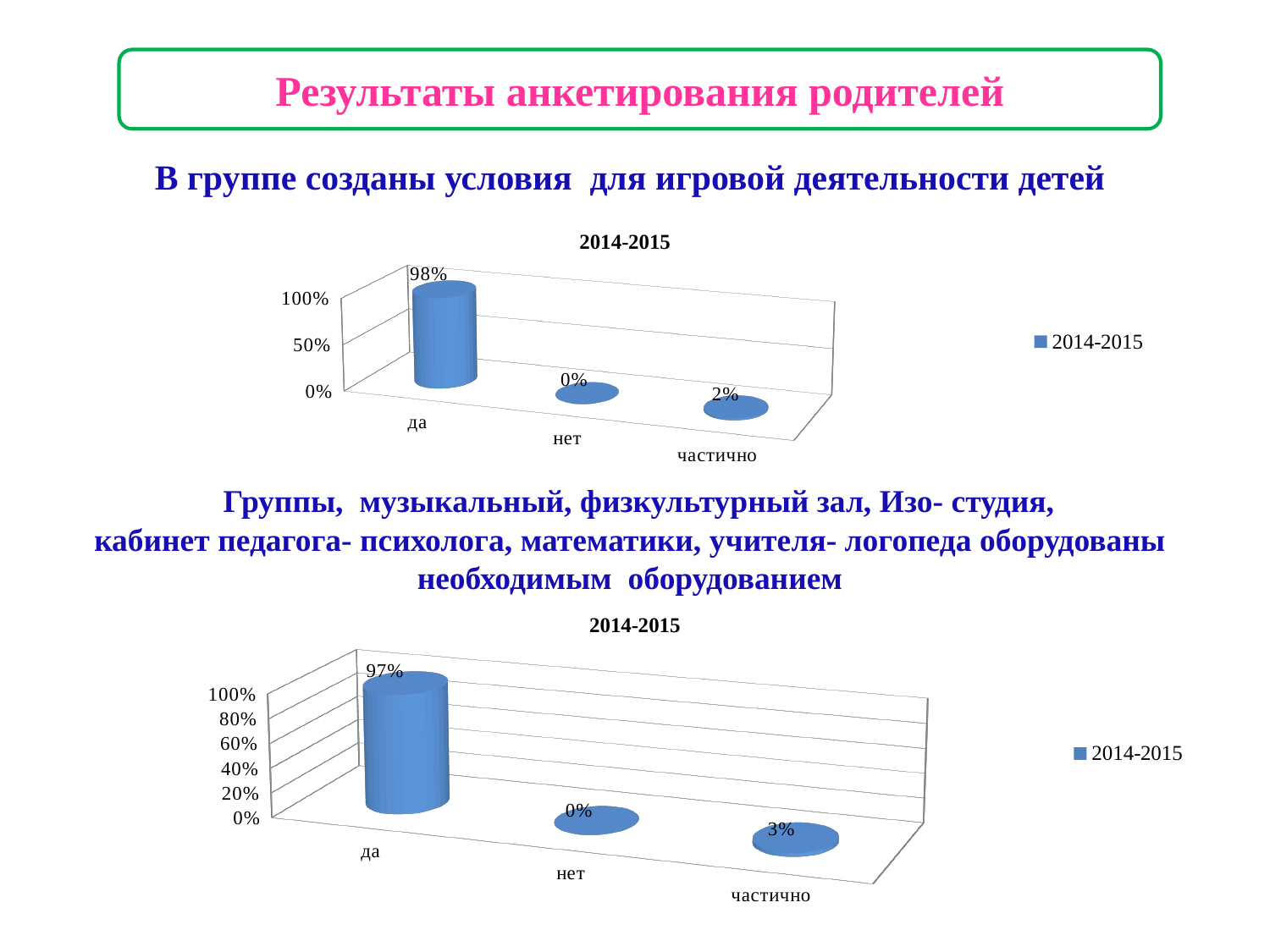
In the bottom chart, what is the value for "да"? 97% In the top chart, what is the value for "да"? 98% In the top chart, what is the value for "нет"? 0% In the bottom chart, which category has the lowest value? нет In the bottom chart, what is the value for "частично"? 3% In the bottom chart, what is the difference between the values for "да" and "частично"? 94% In the top chart, which category has the highest value? да How many categories are shown in the top chart? 3 In the top chart, what is the value for "частично"? 2% In the bottom chart, which is larger, the value for "частично" or the value for "нет"? частично In the top chart, what is the difference between the values for "да" and "частично"? 96% What kind of chart is the bottom chart? bar chart